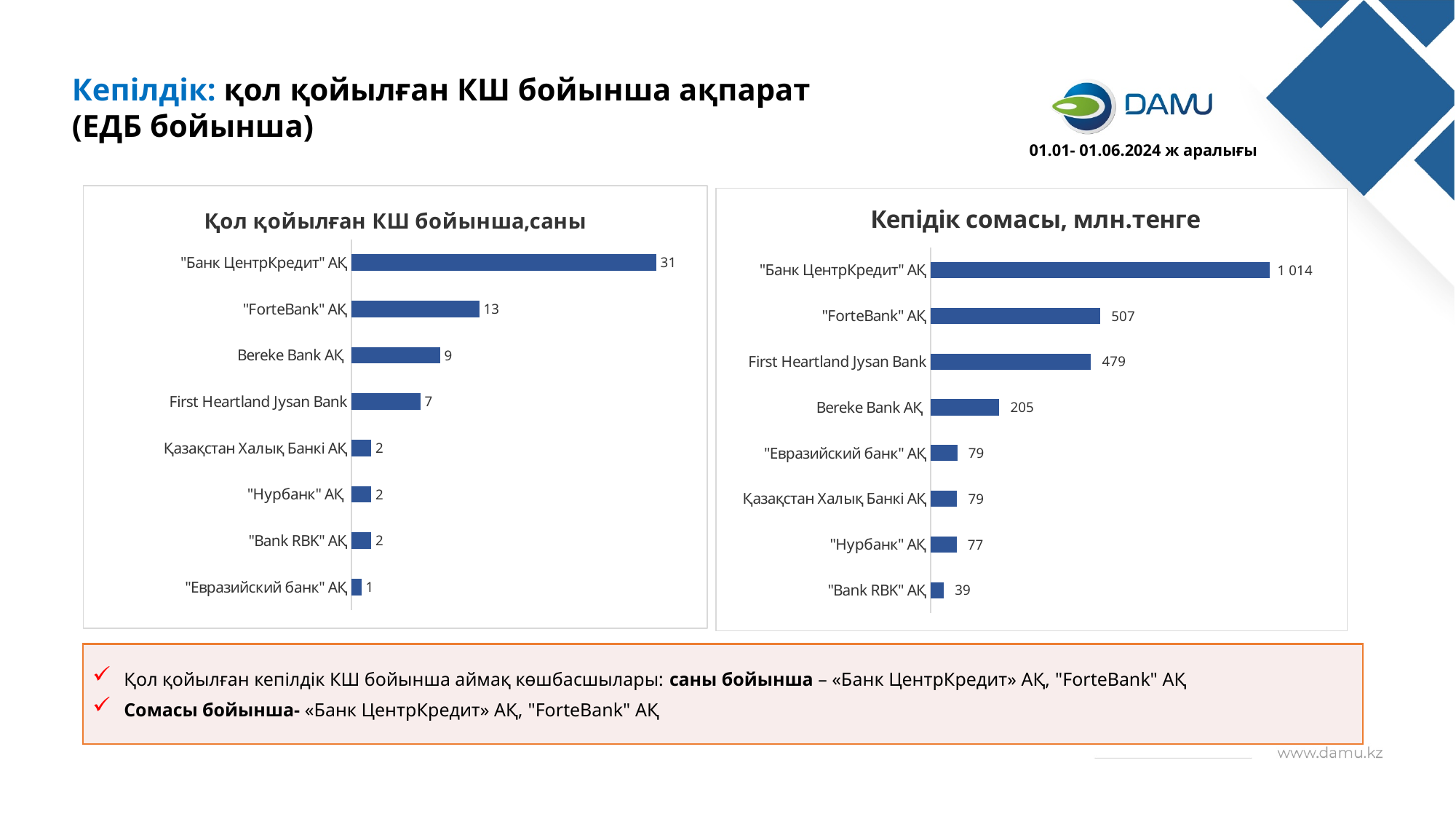
In the chart titled "Кепідік сомасы, млн.тенге", what is the value for First Heartland Jysan Bank? 479 In the chart titled "Кепідік сомасы, млн.тенге", what is the value for "Банк ЦентрКредит" АҚ? 1 014 What kind of chart is the chart titled "Кепідік сомасы, млн.тенге"? Bar chart How many banks are shown in the chart titled "Қол қойылған КШ бойынша,саны"? 8 In the chart titled "Кепідік сомасы, млн.тенге", what is the difference between the values for "ForteBank" АҚ and Bereke Bank АҚ? 302 What is the title of the chart on the left side of the slide? Қол қойылған КШ бойынша,саны In the chart titled "Қол қойылған КШ бойынша,саны", what is the value for "ForteBank" АҚ? 13 In the chart titled "Қол қойылған КШ бойынша,саны", what is the value for "Евразийский банк" АҚ? 1 In the chart titled "Кепідік сомасы, млн.тенге", which is larger: the value for Bereke Bank АҚ or the value for "Евразийский банк" АҚ? Bereke Bank АҚ In the chart titled "Кепідік сомасы, млн.тенге", which bank has the lowest value? "Bank RBK" АҚ In the chart titled "Қол қойылған КШ бойынша,саны", which bank has the highest value? "Банк ЦентрКредит" АҚ In the chart titled "Қол қойылған КШ бойынша,саны", what is the difference between the values for "Банк ЦентрКредит" АҚ and "ForteBank" АҚ? 18